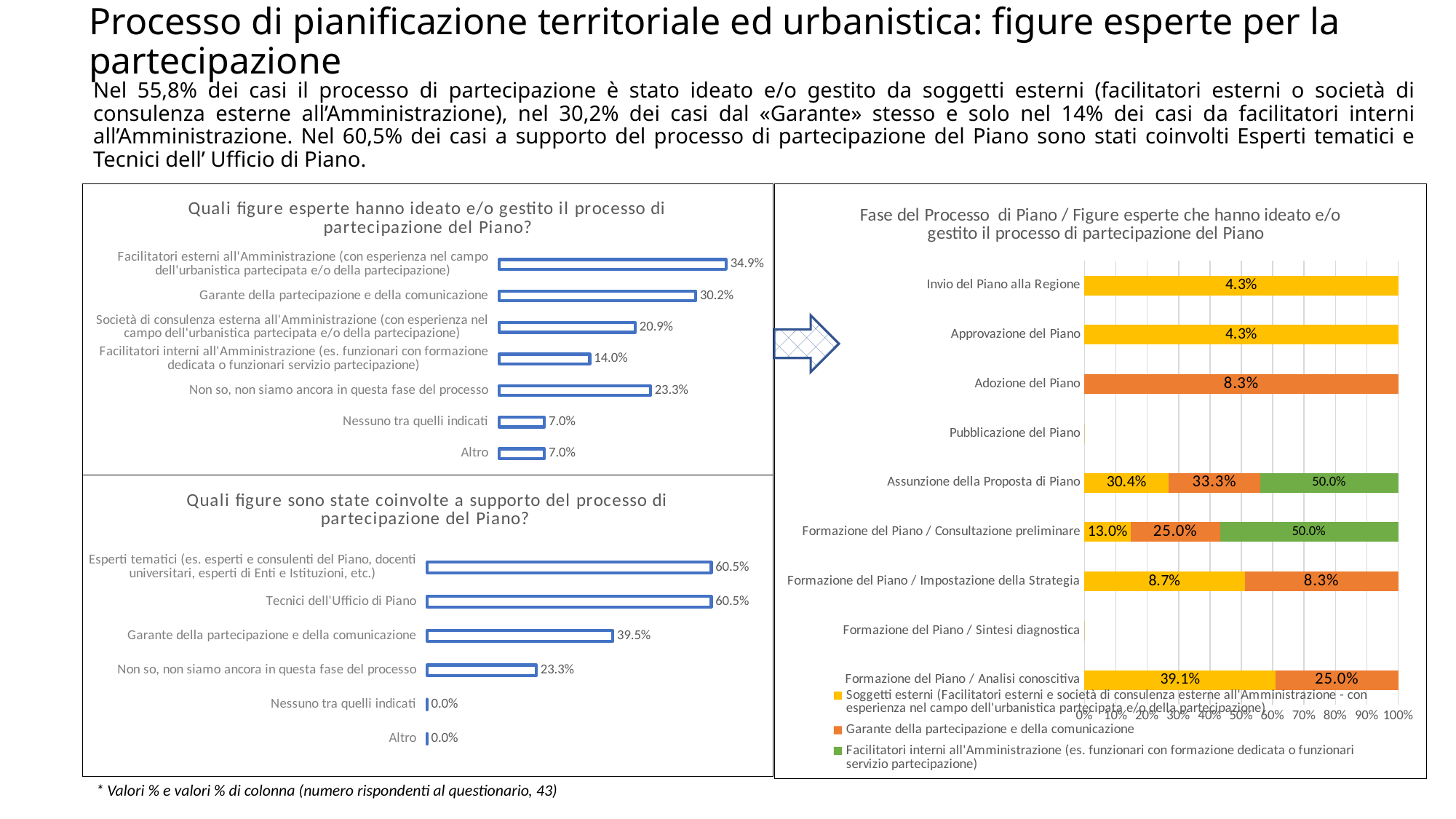
In the chart 'Quali figure esperte hanno ideato e/o gestito il processo di partecipazione del Piano?', which category has the highest value? Facilitatori esterni all'Amministrazione (con esperienza nel campo dell'urbanistica partecipata e/o della partecipazione) In the chart 'Quali figure esperte hanno ideato e/o gestito il processo di partecipazione del Piano?', what is the value for 'Garante della partecipazione e della comunicazione'? 30.2% In the chart 'Quali figure esperte hanno ideato e/o gestito il processo di partecipazione del Piano?', what is the difference between the values for 'Facilitatori esterni all'Amministrazione' and 'Facilitatori interni all'Amministrazione'? 20.9% What type of chart is 'Quali figure sono state coinvolte a supporto del processo di partecipazione del Piano?'? Bar chart How many categories are shown in the chart 'Quali figure esperte hanno ideato e/o gestito il processo di partecipazione del Piano?'? 7 In the chart 'Quali figure sono state coinvolte a supporto del processo di partecipazione del Piano?', which is larger: the value for 'Garante della partecipazione e della comunicazione' or 'Non so, non siamo ancora in questa fase del processo'? Garante della partecipazione e della comunicazione In the chart 'Quali figure sono state coinvolte a supporto del processo di partecipazione del Piano?', what is the value for 'Altro'? 0.0% In the chart 'Fase del Processo di Piano / Figure esperte che hanno ideato e/o gestito il processo di partecipazione del Piano', what is the value of 'Soggetti esterni' for 'Formazione del Piano / Analisi conoscitiva'? 39.1% In the chart 'Quali figure sono state coinvolte a supporto del processo di partecipazione del Piano?', what is the value for 'Tecnici dell'Ufficio di Piano'? 60.5% In the chart 'Fase del Processo di Piano / Figure esperte che hanno ideato e/o gestito il processo di partecipazione del Piano', what is the value of 'Garante della partecipazione e della comunicazione' for 'Assunzione della Proposta di Piano'? 33.3% In the chart 'Fase del Processo di Piano / Figure esperte che hanno ideato e/o gestito il processo di partecipazione del Piano', which colour represents 'Facilitatori interni all'Amministrazione'? Green How many series does the legend list in the chart 'Fase del Processo di Piano / Figure esperte che hanno ideato e/o gestito il processo di partecipazione del Piano'? 3